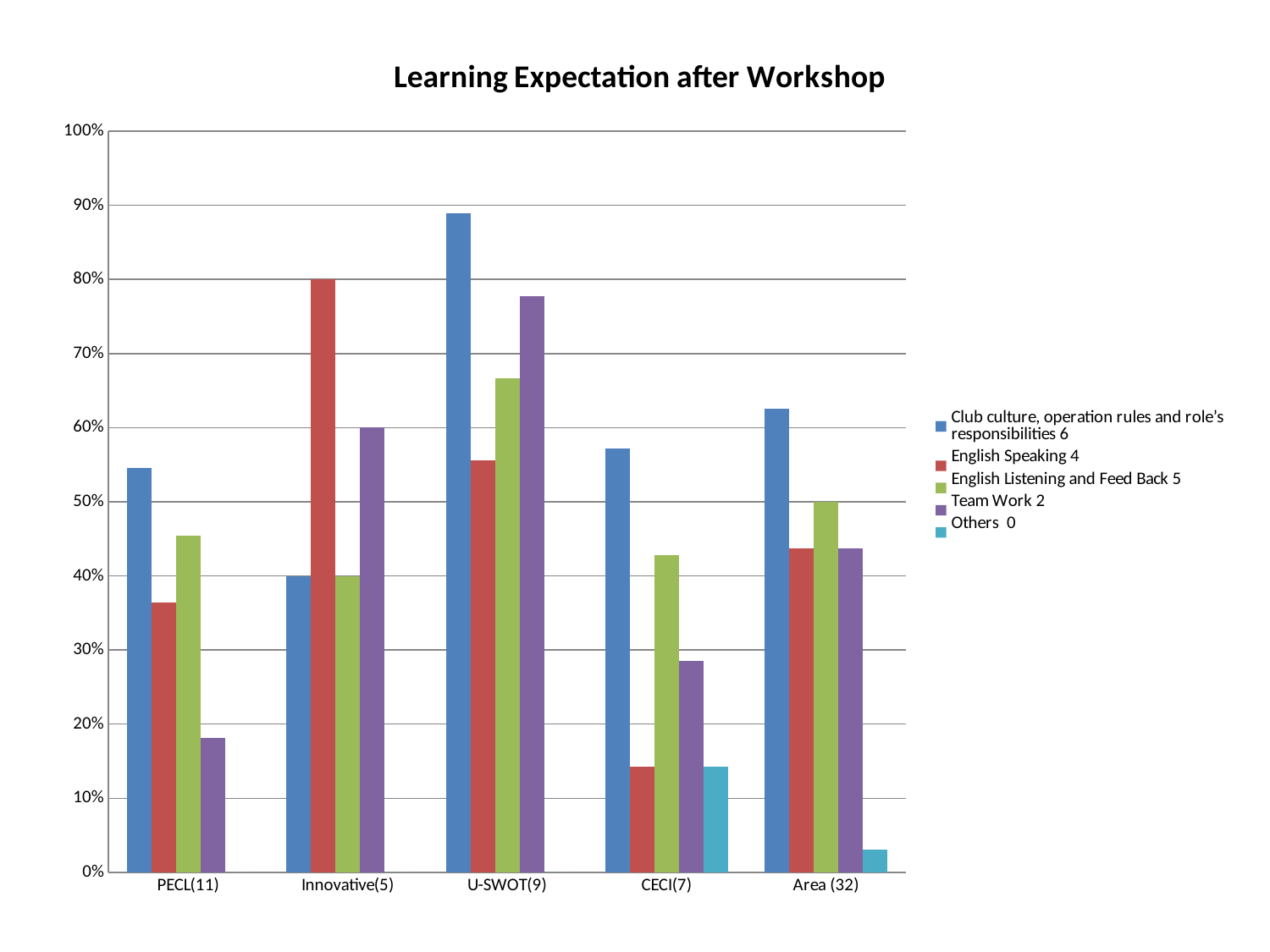
Which category has the lowest value for Team Work 2? PECL(11) Is the value for Others 0 in CECI(7) greater or less than 20%? less What type of chart is shown on the slide? bar chart In the PECL(11) category, which is larger: English Speaking 4 or English Listening and Feed Back 5? English Listening and Feed Back 5 What is the value for English Listening and Feed Back 5 in the Area (32) category? 50% How many series does the legend list? 5 Which category has the highest value for Club culture, operation rules and role's responsibilities 6? U-SWOT(9) What is the title of the chart? Learning Expectation after Workshop Is the value for Club culture, operation rules and role's responsibilities 6 in U-SWOT(9) greater or less than 80%? greater What is the value for English Speaking 4 in the Innovative(5) category? 80% How many categories are shown on the x axis? 5 What is the value for Team Work 2 in the Innovative(5) category? 60%